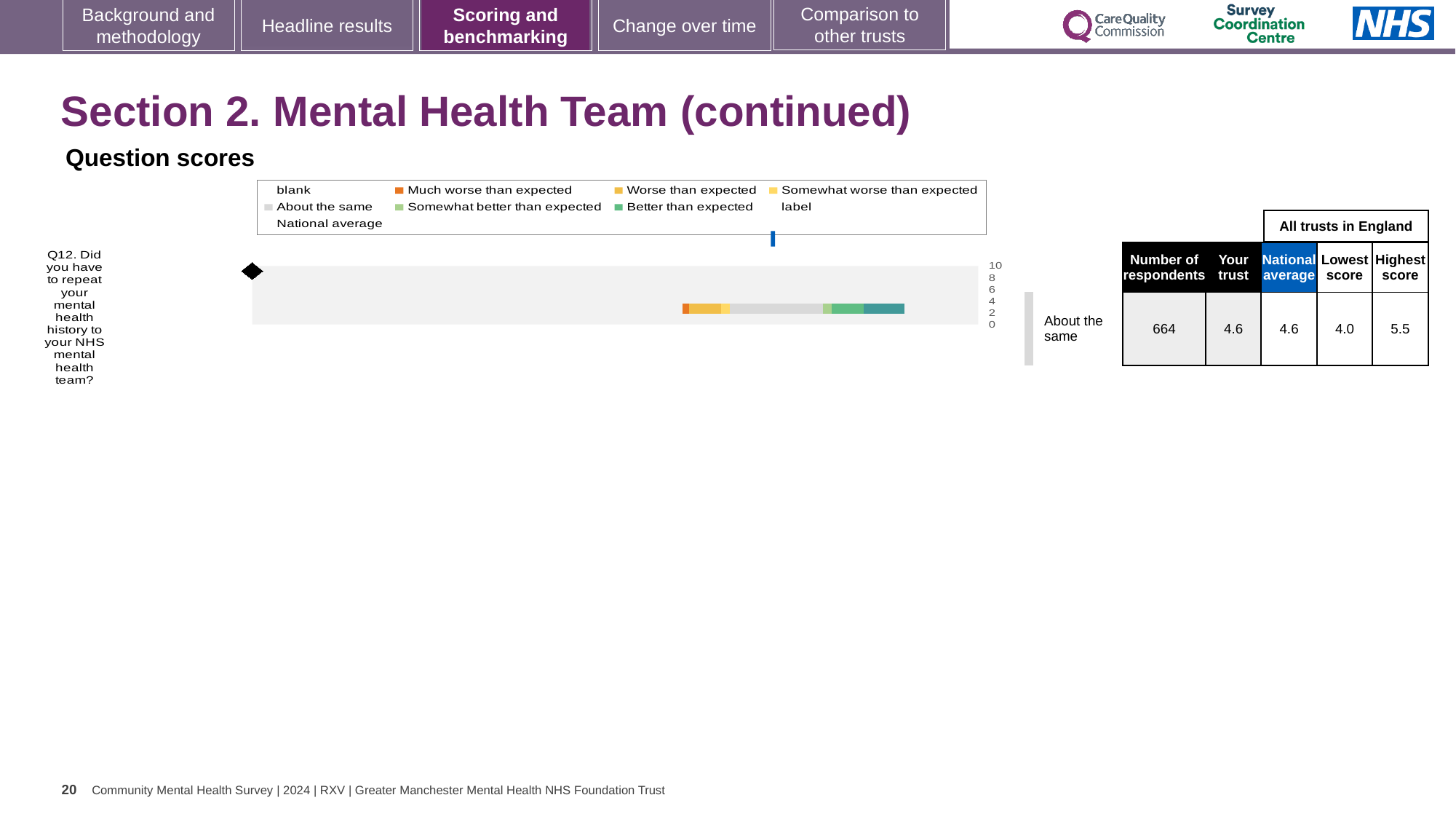
Which is larger for Q12: the highest score or the 'Your trust' score? Highest score Which legend entry is shown in orange? Much worse than expected Which question is plotted in the chart? Q12. Did you have to repeat your mental health history to your NHS mental health team? How many survey questions are plotted in the chart? 1 What is the difference between the highest score and the lowest score for Q12? 1.5 What is the highest score among all trusts in England for Q12? 5.5 What is the lowest score among all trusts in England for Q12? 4.0 What is the national average score for Q12? 4.6 What is the 'Your trust' score for Q12? 4.6 What benchmarking category is shown for Q12 next to the chart? About the same What is the number of respondents for Q12? 664 What kind of chart is used to show the Q12 benchmarking result? bar chart